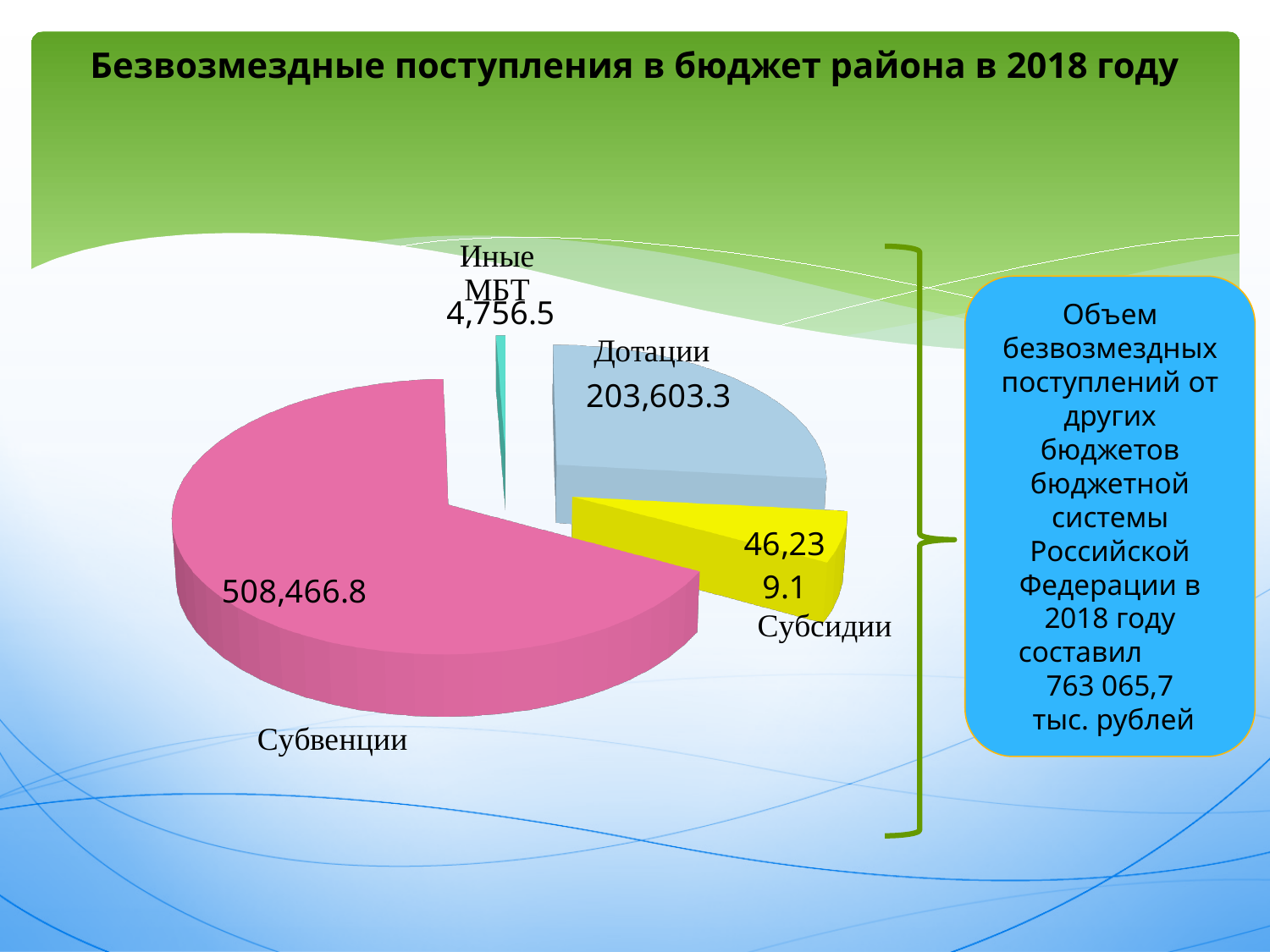
What is the title of the slide containing the chart? Безвозмездные поступления в бюджет района в 2018 году What is the value for Субвенции? 508,466.8 What is the difference between the values for Субвенции and Дотации? 304,863.5 What is the value for Субсидии? 46,239.1 Which category has the largest slice of the pie? Субвенции How many slices does the pie chart have? 4 What is the difference between the values for Субсидии and Иные МБТ? 41,482.6 Which category has the smallest slice of the pie? Иные МБТ What is the value for Иные МБТ? 4,756.5 What type of chart is shown on the slide? pie chart Which is larger, Дотации or Субсидии? Дотации What is the value for Дотации? 203,603.3